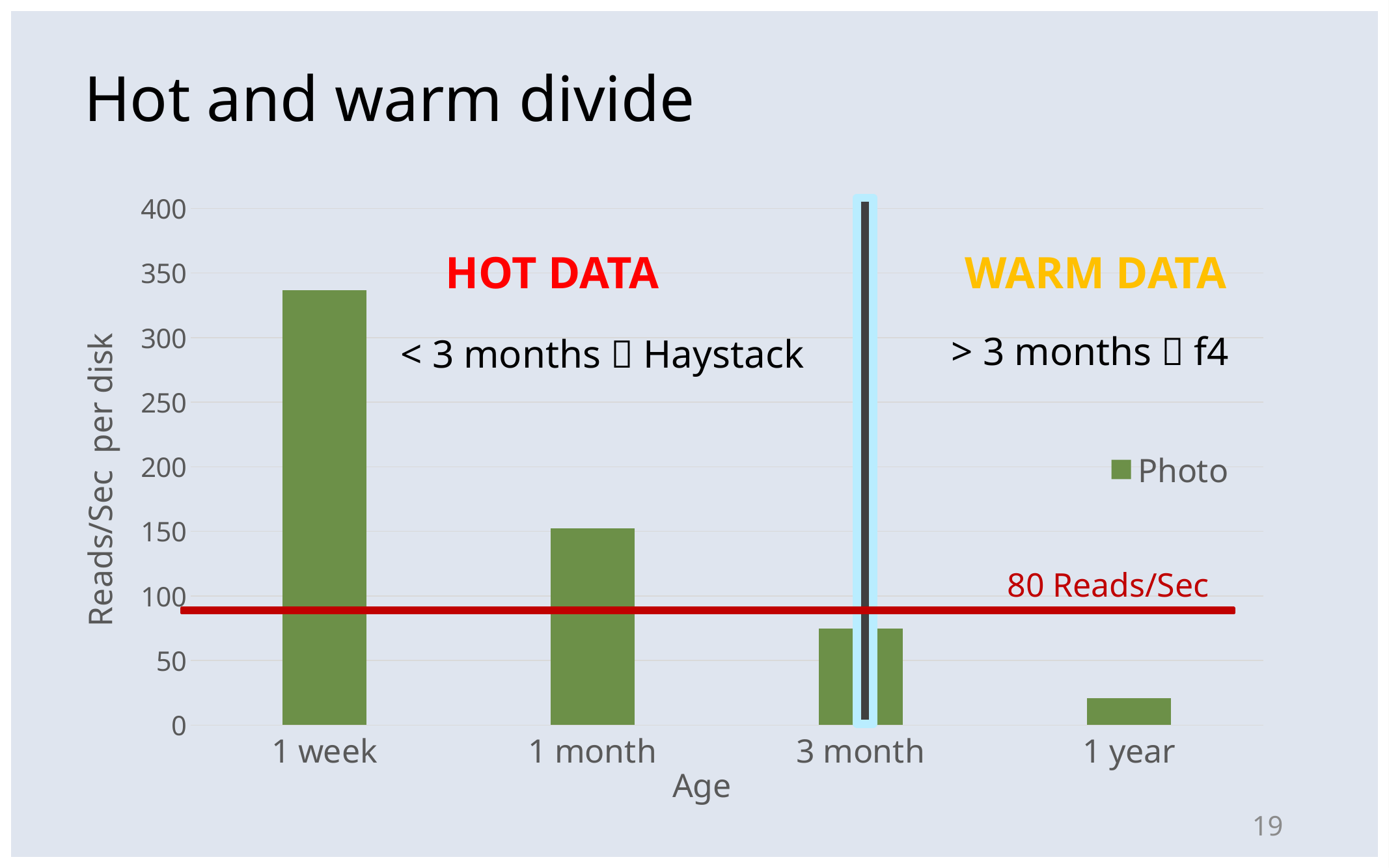
Is the value for 1 month greater or less than 200? less What is the label on the red horizontal line across the chart? 80 Reads/Sec Which has a higher value, 1 month or 3 month? 1 month Is the value for 1 week greater or less than 300? greater Which age category has the highest reads per second per disk? 1 week Is the value for 3 month greater or less than 100? less Do the values rise or fall as age increases along the x axis? fall How many series does the legend list? 1 How many age categories are plotted on the x axis? 4 Which age category has the lowest reads per second per disk? 1 year What kind of chart is shown on the slide? bar chart